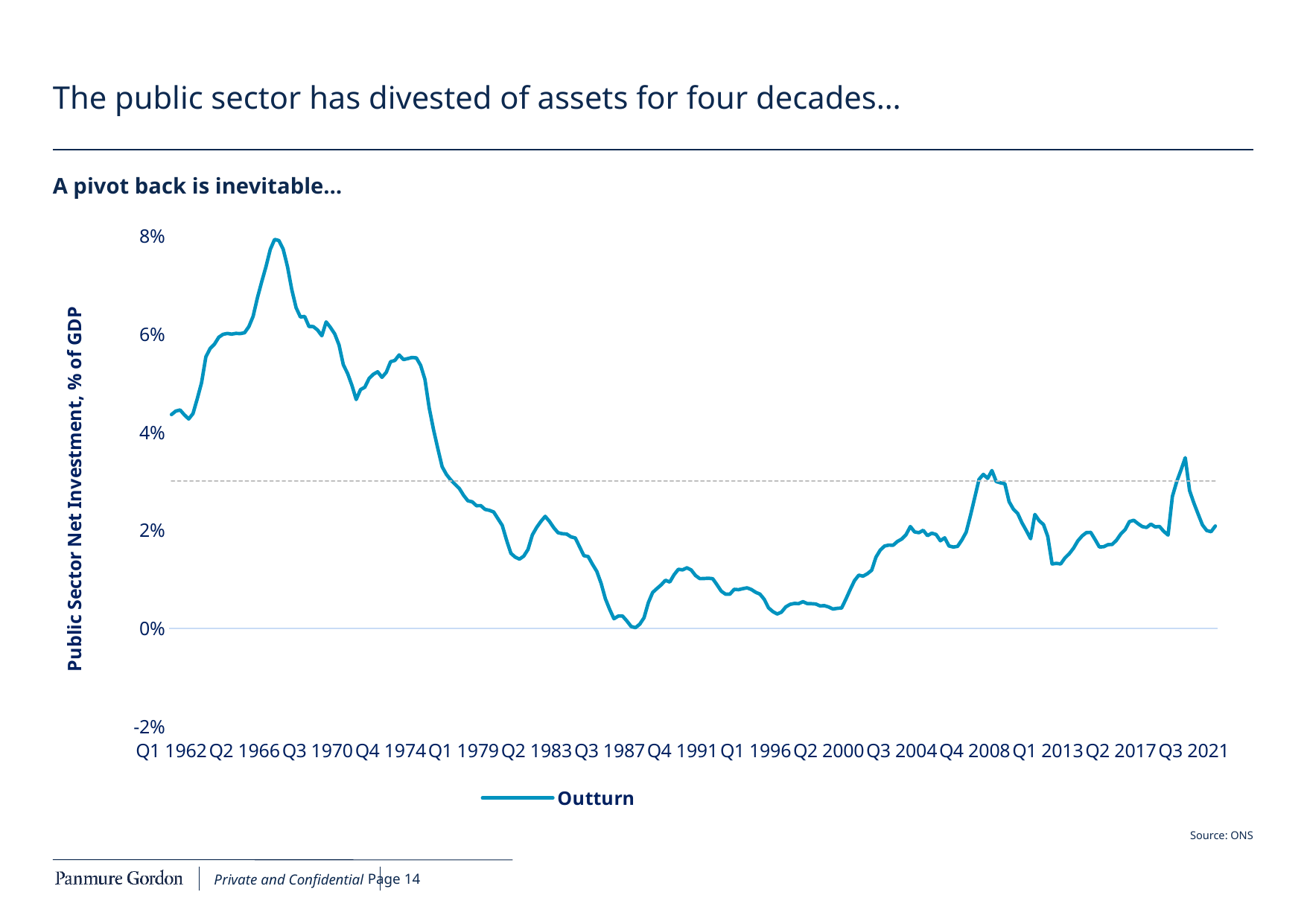
Does the Outturn line rise or fall between Q4 1974 and Q3 1987? fall Is the value for Q1 1962 greater or less than 4%? greater What is the label of the vertical axis? Public Sector Net Investment, % of GDP Is the value for Q3 1987 greater or less than 2%? less Is the value for Q3 1970 greater or less than 4%? greater How many series does the legend list? 1 Which is larger, the value at Q3 1970 or the value at Q1 1996? Q3 1970 What kind of chart is shown on the slide? Line chart How many labelled points are shown on the x axis? 15 What is the name of the series shown in the legend? Outturn